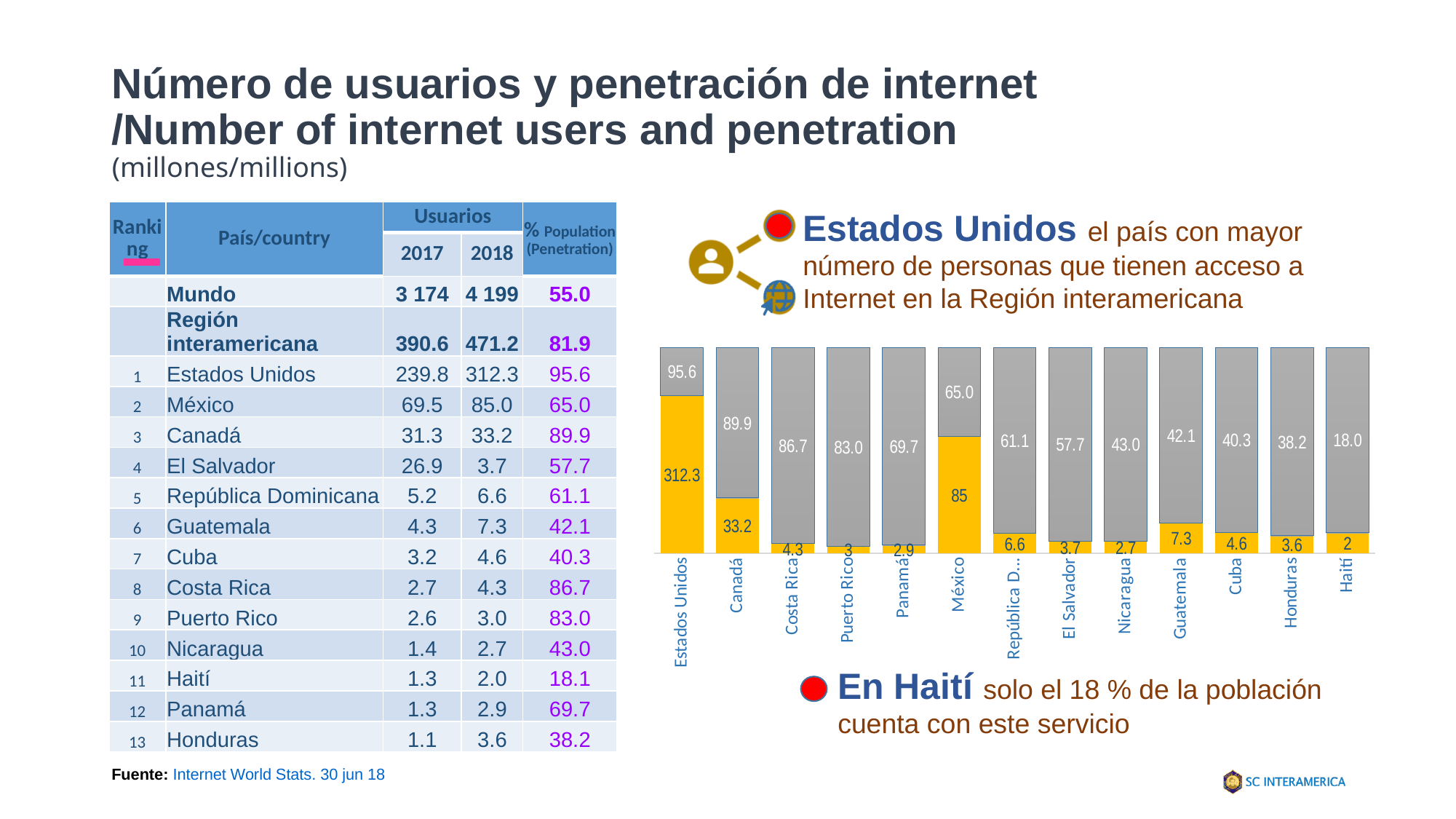
In the bar chart on the right, what value is printed on the yellow bar for México? 85 In the bar chart on the right, what value is printed on the yellow bar for Guatemala? 7.3 What kind of chart is shown on the right of the slide? Bar chart In the bar chart on the right, what value is printed on the grey bar for Haití? 18.0 In the bar chart on the right, what is the difference between the yellow-bar values for Guatemala (7.3) and Cuba (4.6)? 2.7 In the bar chart on the right, what colour is the bar segment labelled 312.3? Yellow In the bar chart on the right, which country has the lowest grey-bar value? Haití In the bar chart on the right, what is the difference between the grey-bar values for Estados Unidos (95.6) and Canadá (89.9)? 5.7 How many countries are shown along the x axis of the bar chart on the right? 13 In the bar chart on the right, which country has the tallest yellow bar? Estados Unidos In the bar chart on the right, do the grey-bar values rise or fall from left to right along the x axis? Fall In the bar chart on the right, which has the larger yellow-bar value, Canadá or México? México